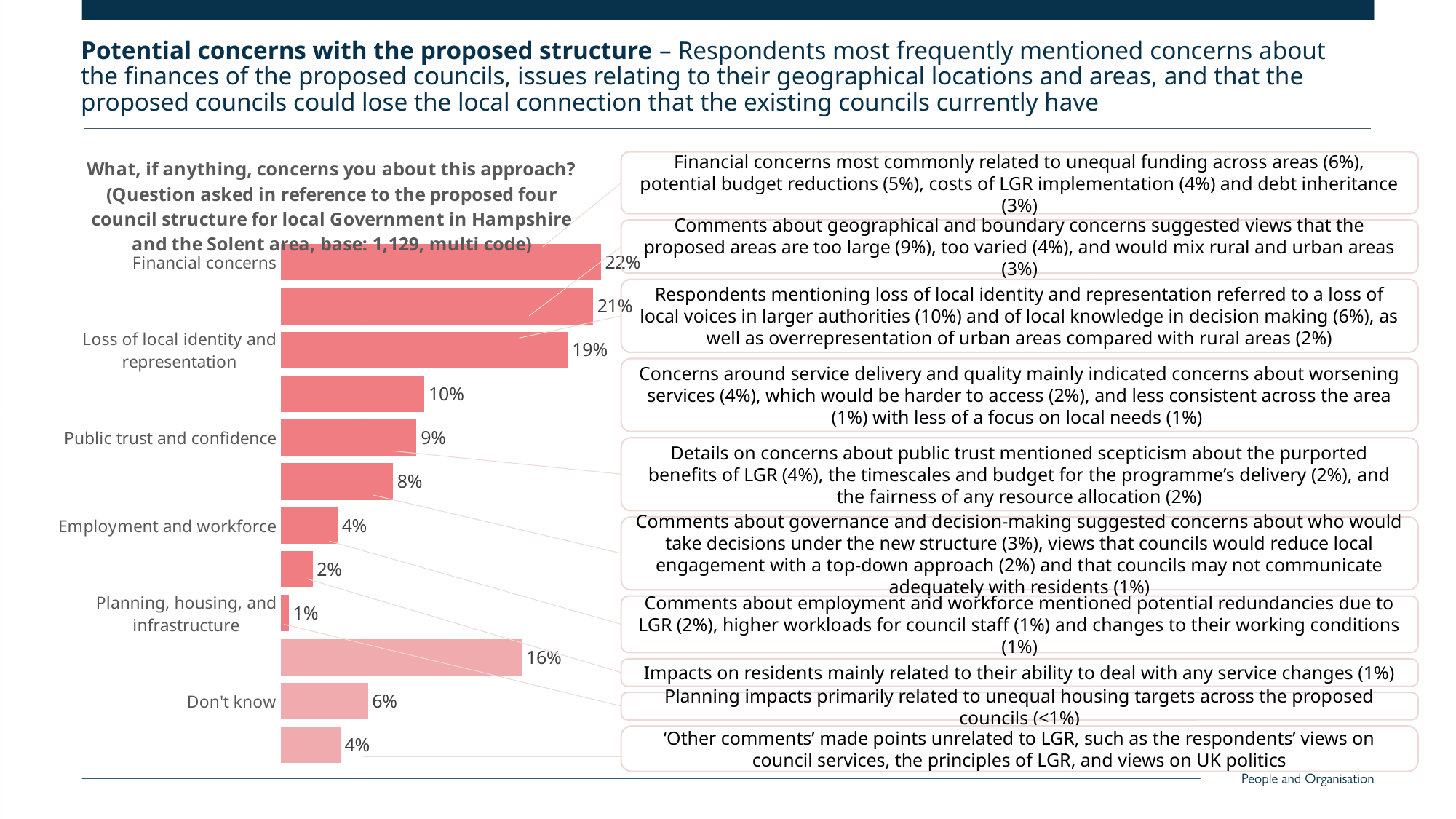
Which is larger: the percentage for Public trust and confidence or for Don't know? Public trust and confidence What percentage of respondents mentioned Financial concerns? 22% Which labelled concern has the lowest percentage of respondents? Planning, housing, and infrastructure What percentage of respondents mentioned Employment and workforce? 4% What is the difference in percentage points between Financial concerns and Loss of local identity and representation? 3 percentage points What percentage of respondents mentioned Planning, housing, and infrastructure? 1% What percentage of respondents mentioned Loss of local identity and representation? 19% What type of chart is shown on the slide? Bar chart How many bars are plotted in the chart? 12 Which labelled concern has the highest percentage of respondents? Financial concerns What percentage of respondents mentioned Public trust and confidence? 9% What percentage of respondents answered Don't know? 6%